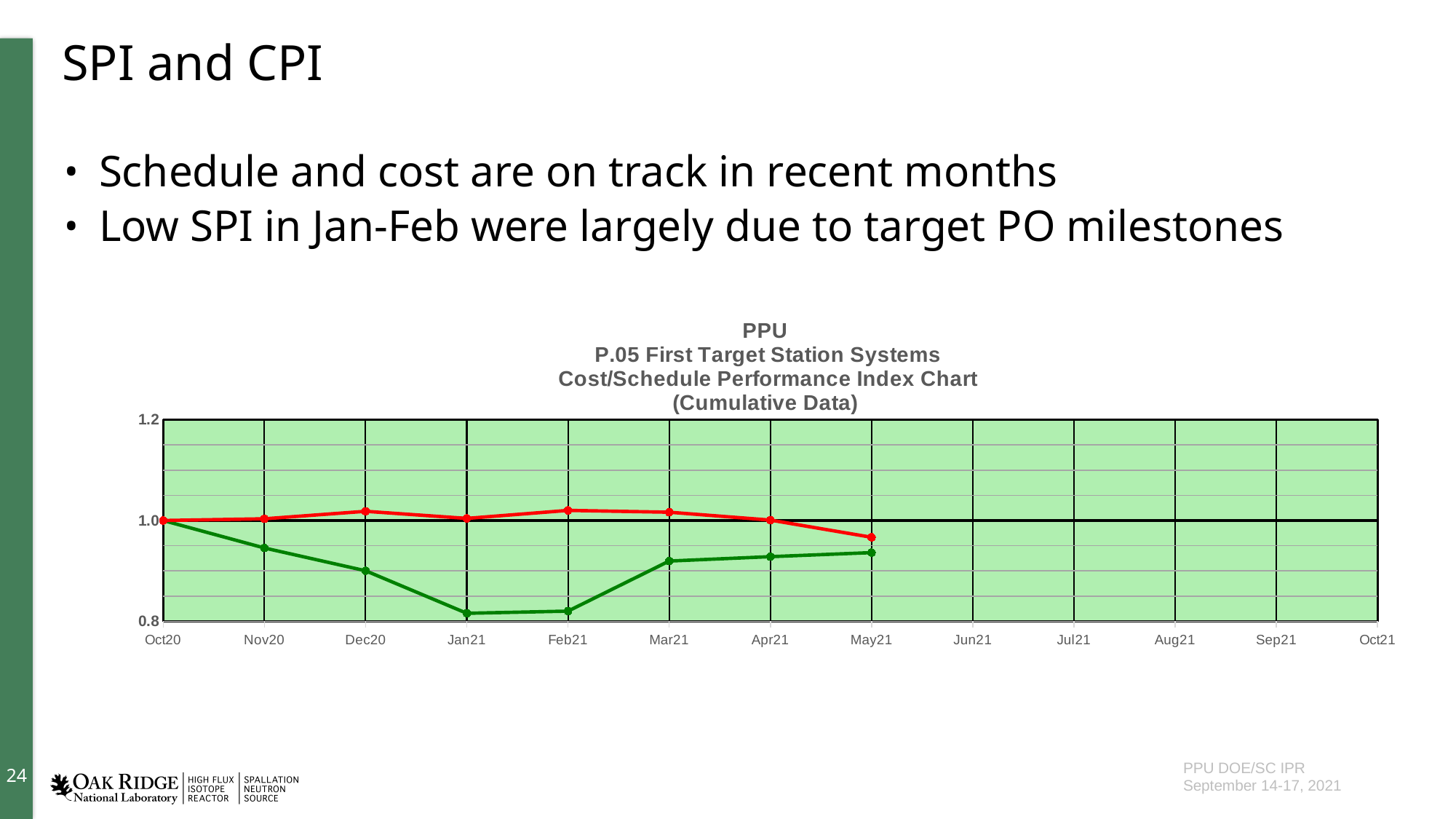
How many data points are plotted on the green line? 8 At which month does the green line reach its highest value? Oct20 Is the value of the green line at Jan21 greater or less than 1.0? less At Jan21, which line has the higher value, the red line or the green line? the red line What is the last month on the x axis for which data points are plotted? May21 Is the value of the green line at Dec20 greater or less than 1.0? less How many lines are plotted on the chart? 2 What kind of chart is shown on the slide? line chart Which is higher for the green line, Nov20 or Dec20? Nov20 How many month labels are shown along the x axis of the chart? 13 What is the value of the green line at Oct20? 1.0 Does the green line rise or fall from Oct20 to Jan21? fall